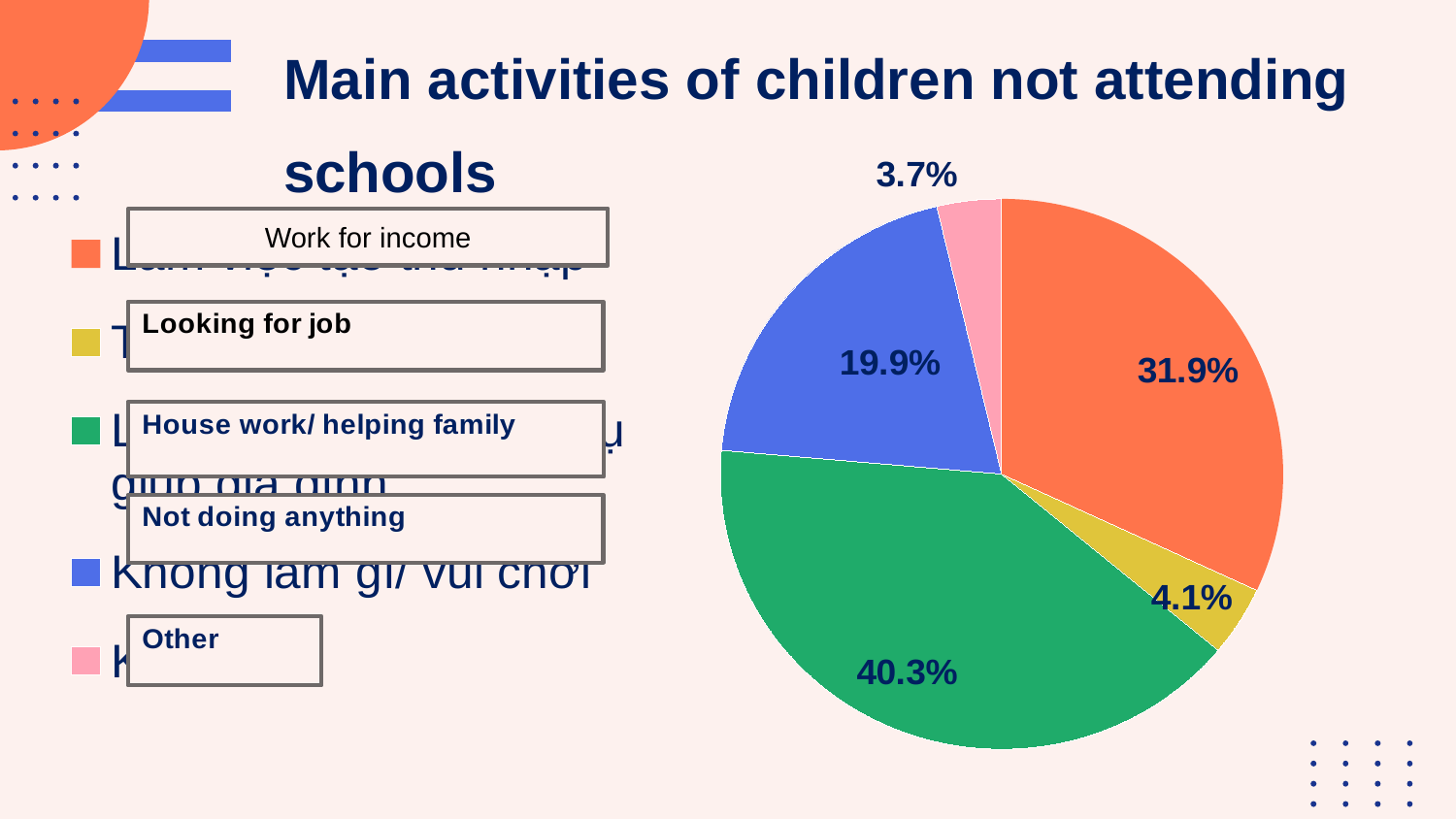
Which is larger, the share for Not doing anything or the share for Looking for job? Not doing anything What colour is the slice for Other? Pink What percentage is shown for Not doing anything? 19.9% What percentage is shown for Looking for job? 4.1% What is the title of the slide? Main activities of children not attending schools How many slices does the pie chart have? 5 What percentage is shown for Work for income? 31.9% What is the difference in percentage points between House work/ helping family and Work for income? 8.4 Which activity has the largest slice of the pie? House work/ helping family What share of the pie does House work/ helping family account for? 40.3% What type of chart is shown on the slide? Pie chart Which activity has the smallest slice of the pie? Other